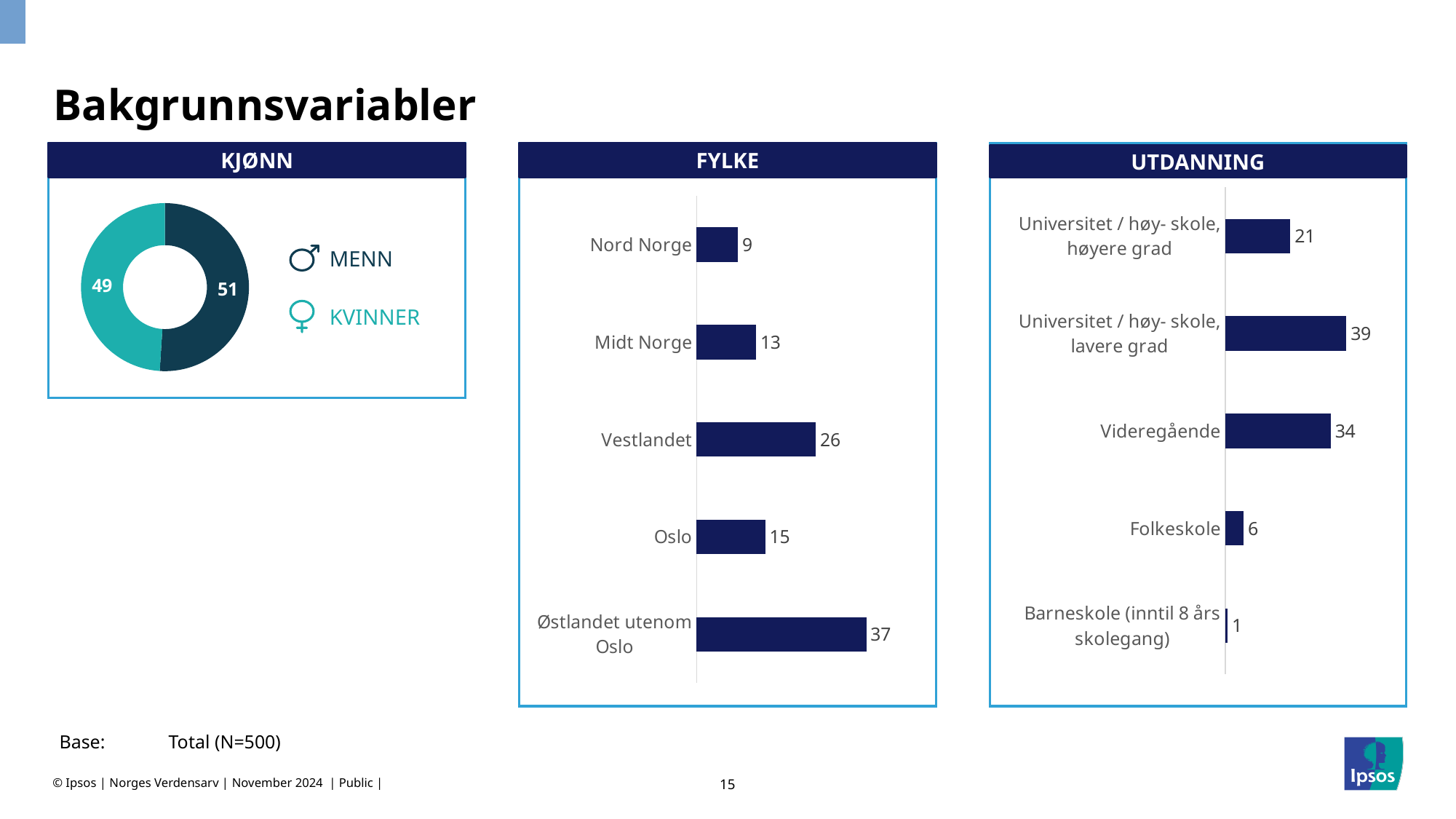
In the FYLKE chart, what is the difference between Østlandet utenom Oslo and Oslo? 22 In the KJØNN chart, what is the value for KVINNER? 49 In the KJØNN chart, what is the value for MENN? 51 How many categories are shown in the FYLKE chart? 5 What kind of chart is the KJØNN chart? Donut chart What kind of chart is the UTDANNING chart? Bar chart In the UTDANNING chart, what is the value for Videregående? 34 In the FYLKE chart, which category has the highest value? Østlandet utenom Oslo In the FYLKE chart, which category has the lowest value? Nord Norge In the UTDANNING chart, which is larger: Folkeskole or Universitet / høy- skole, høyere grad? Universitet / høy- skole, høyere grad In the FYLKE chart, what is the value for Vestlandet? 26 In the UTDANNING chart, which category has the highest value? Universitet / høy- skole, lavere grad